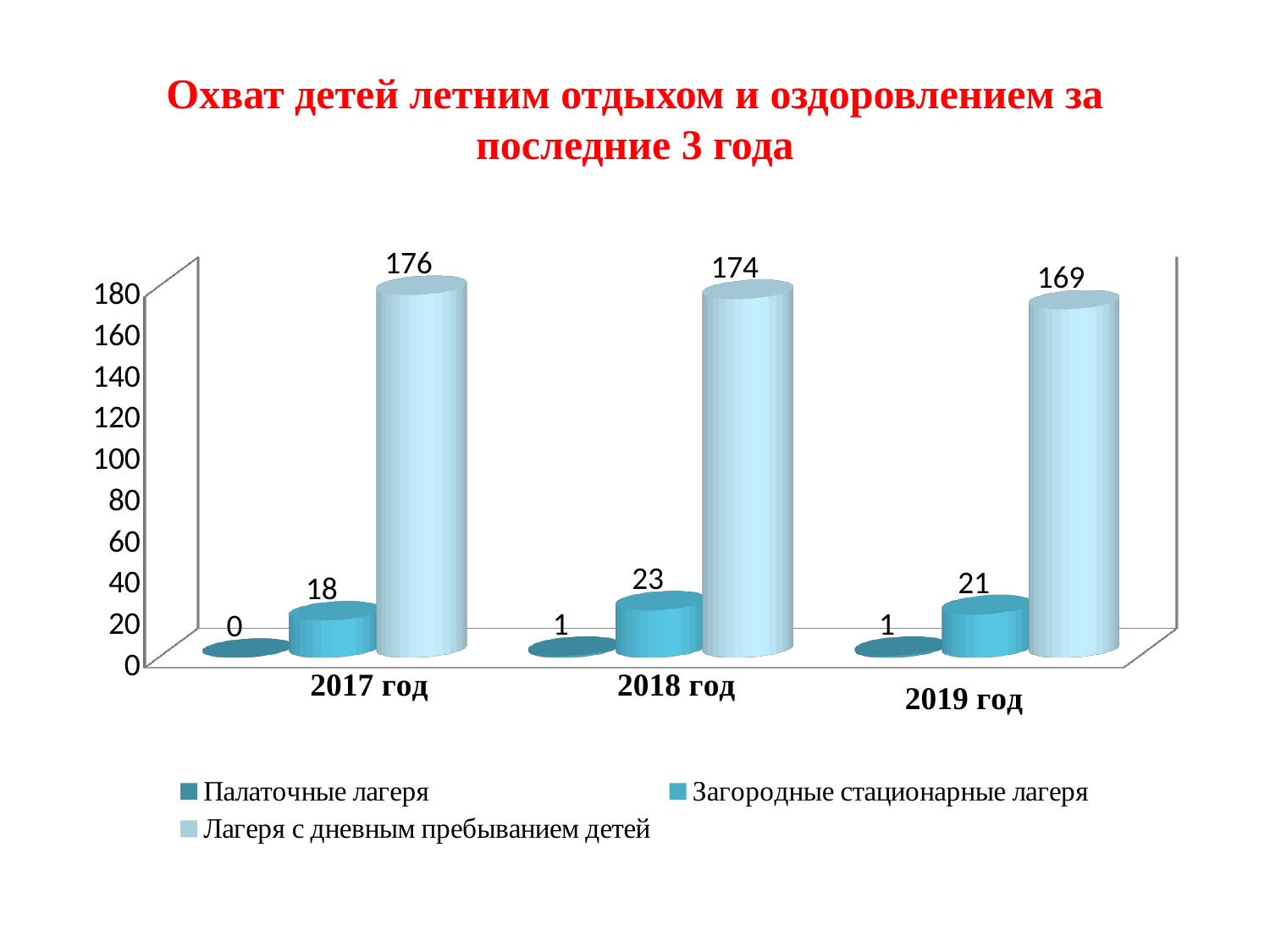
What is the value for Палаточные лагеря in 2017 год? 0 What kind of chart is shown on the slide? Bar chart How many years are shown on the x axis? 3 What is the value for Лагеря с дневным пребыванием детей in 2017 год? 176 Which is larger: Загородные стационарные лагеря in 2018 год or in 2019 год? 2018 год What is the difference between the Лагеря с дневным пребыванием детей values for 2017 год and 2019 год? 7 What is the value for Загородные стационарные лагеря in 2018 год? 23 In which year is the value for Загородные стационарные лагеря the lowest? 2017 год In which year is the value for Лагеря с дневным пребыванием детей the highest? 2017 год Do the values for Лагеря с дневным пребыванием детей rise or fall from 2017 год to 2019 год? Fall What is the value for Лагеря с дневным пребыванием детей in 2019 год? 169 How many series does the legend list? 3